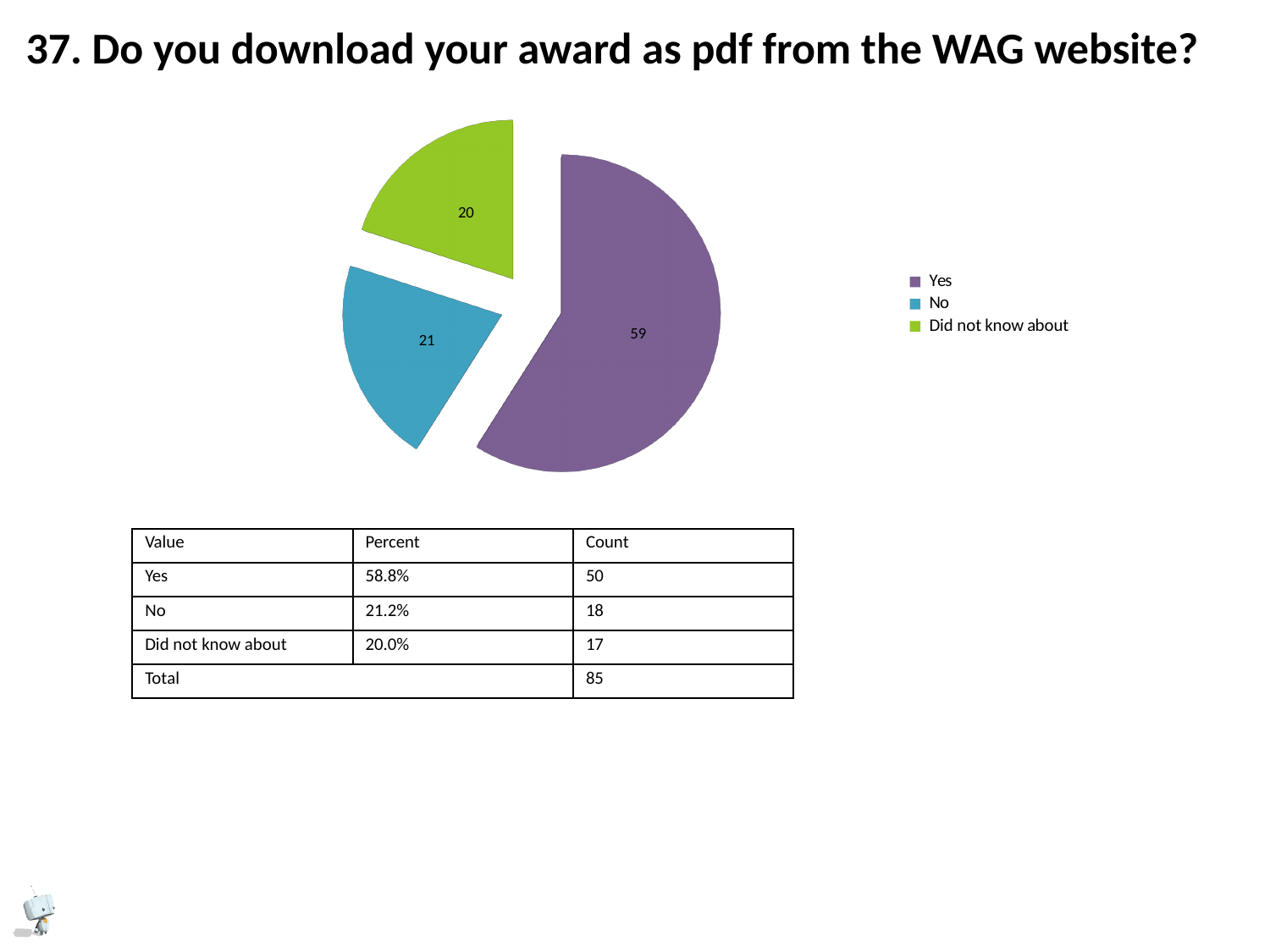
What value is printed on the Did not know about slice of the pie chart? 20 How many entries does the legend list? 3 Which category has the smallest slice in the pie chart? Did not know about Which category has the largest slice in the pie chart? Yes What kind of chart is shown on the slide? pie chart What is the difference between the values printed on the Yes and No slices? 38 How many slices does the pie chart have? 3 What value is printed on the No slice of the pie chart? 21 What value is printed on the Yes slice of the pie chart? 59 Which slice is larger, Yes or No? Yes What colour is the Yes slice in the pie chart? purple What is the difference between the values printed on the No and Did not know about slices? 1